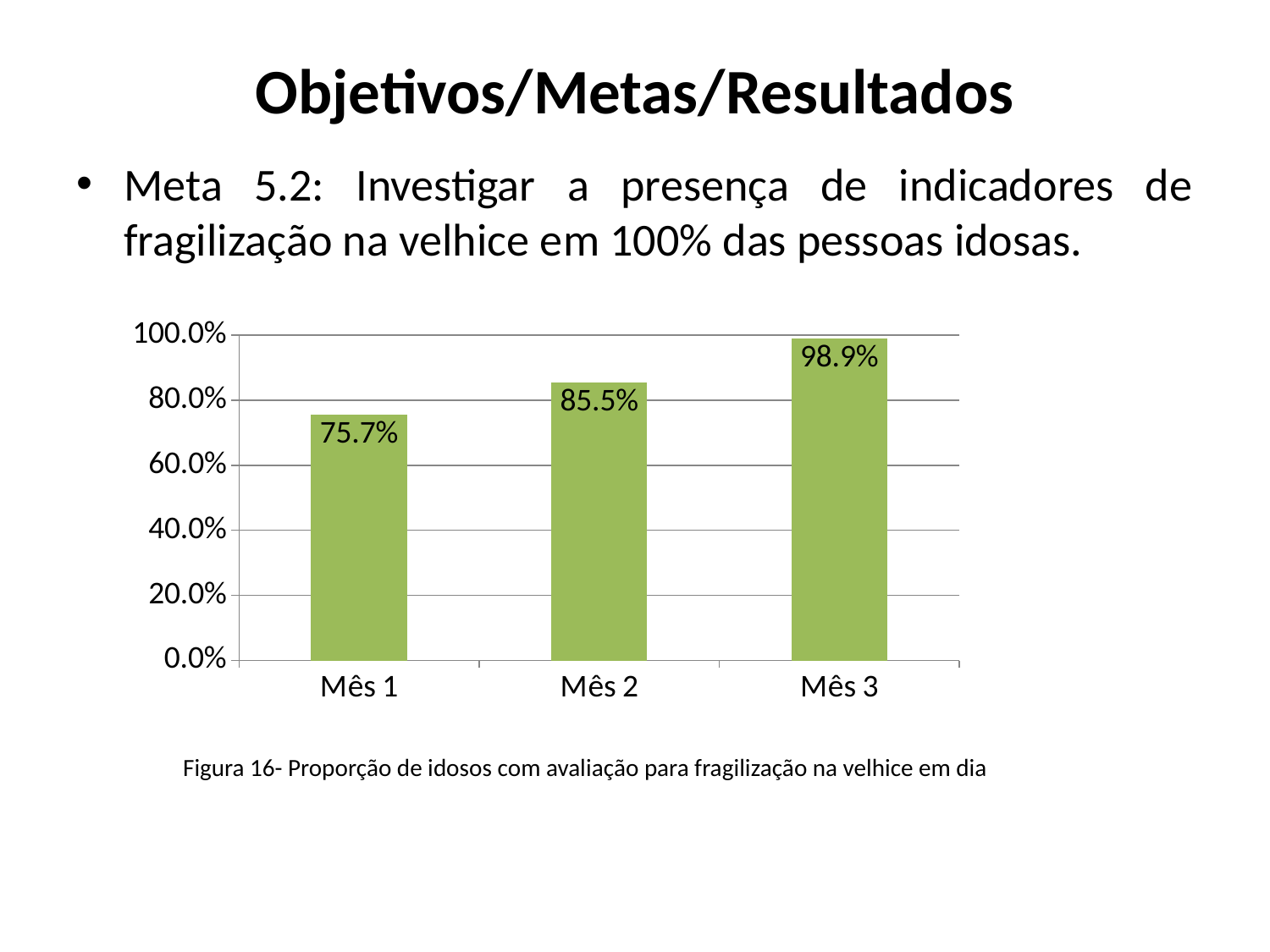
What is the value for Mês 1? 75.7% What kind of chart is shown on the slide? bar chart Do the values rise or fall from Mês 1 to Mês 3? rise How many categories are shown on the x axis? 3 Which month has the lowest value? Mês 1 Which is larger, the value for Mês 2 or the value for Mês 3? Mês 3 What is the difference between the values for Mês 2 and Mês 1? 9.8% What is the value for Mês 2? 85.5% Is the value for Mês 1 greater or less than 80.0%? less What is the value for Mês 3? 98.9% What is the difference between the values for Mês 3 and Mês 1? 23.2% Which month has the highest value? Mês 3